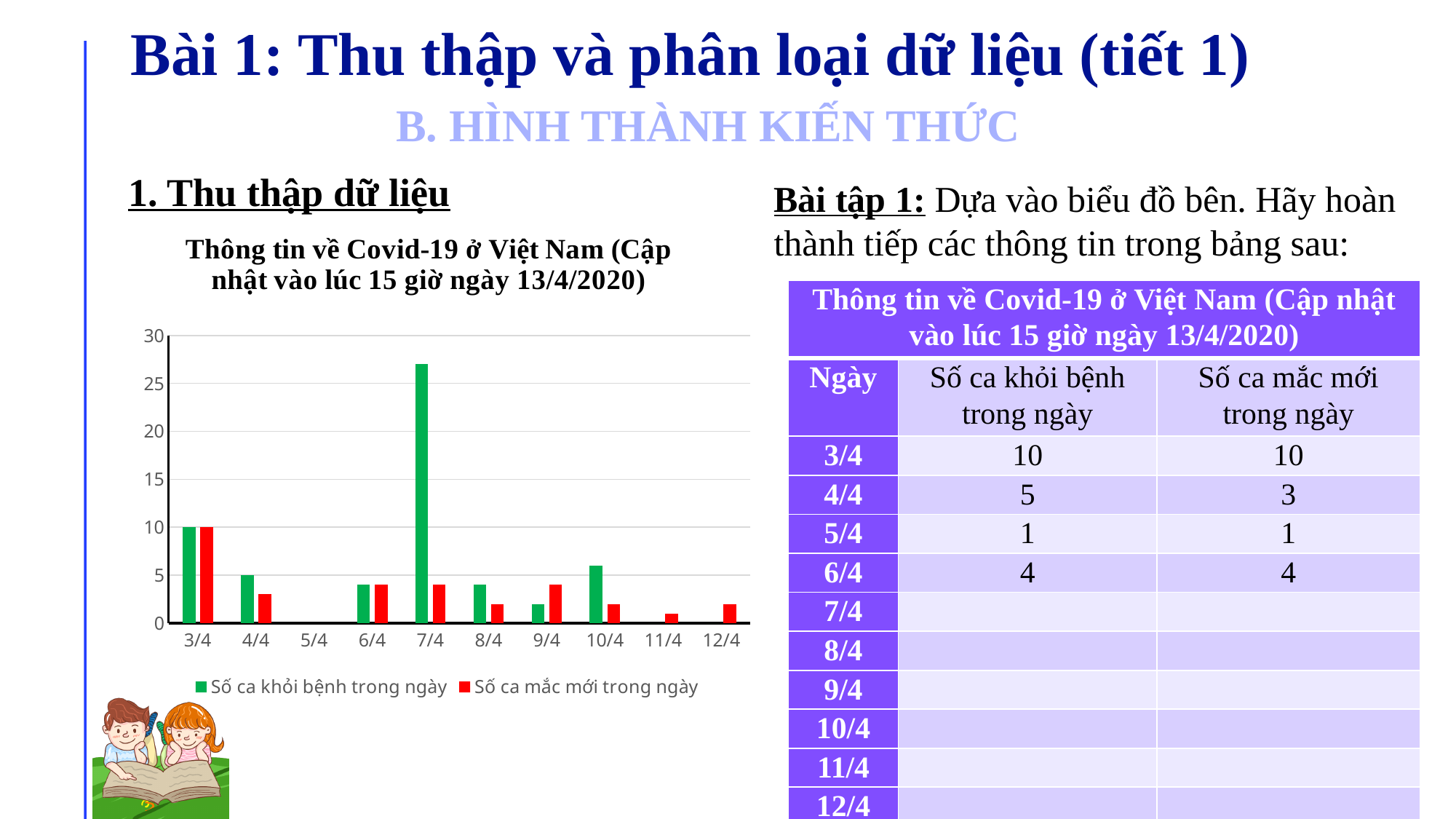
How many series does the chart legend list? 2 What is the value for 'Số ca khỏi bệnh trong ngày' on 4/4? 5 On 9/4, which series has the larger value: 'Số ca khỏi bệnh trong ngày' or 'Số ca mắc mới trong ngày'? Số ca mắc mới trong ngày Is the value for 'Số ca khỏi bệnh trong ngày' on 7/4 greater or less than 25? greater Which colour represents 'Số ca mắc mới trong ngày' in the chart? red On which date is the value for 'Số ca khỏi bệnh trong ngày' highest? 7/4 Is the value for 'Số ca mắc mới trong ngày' on 11/4 greater or less than 5? less What is the value for 'Số ca khỏi bệnh trong ngày' on 3/4? 10 How many dates are shown along the x axis of the chart? 10 What kind of chart is shown on the slide? bar chart Is the value for 'Số ca khỏi bệnh trong ngày' on 10/4 greater or less than 10? less On which date is the value for 'Số ca mắc mới trong ngày' highest? 3/4